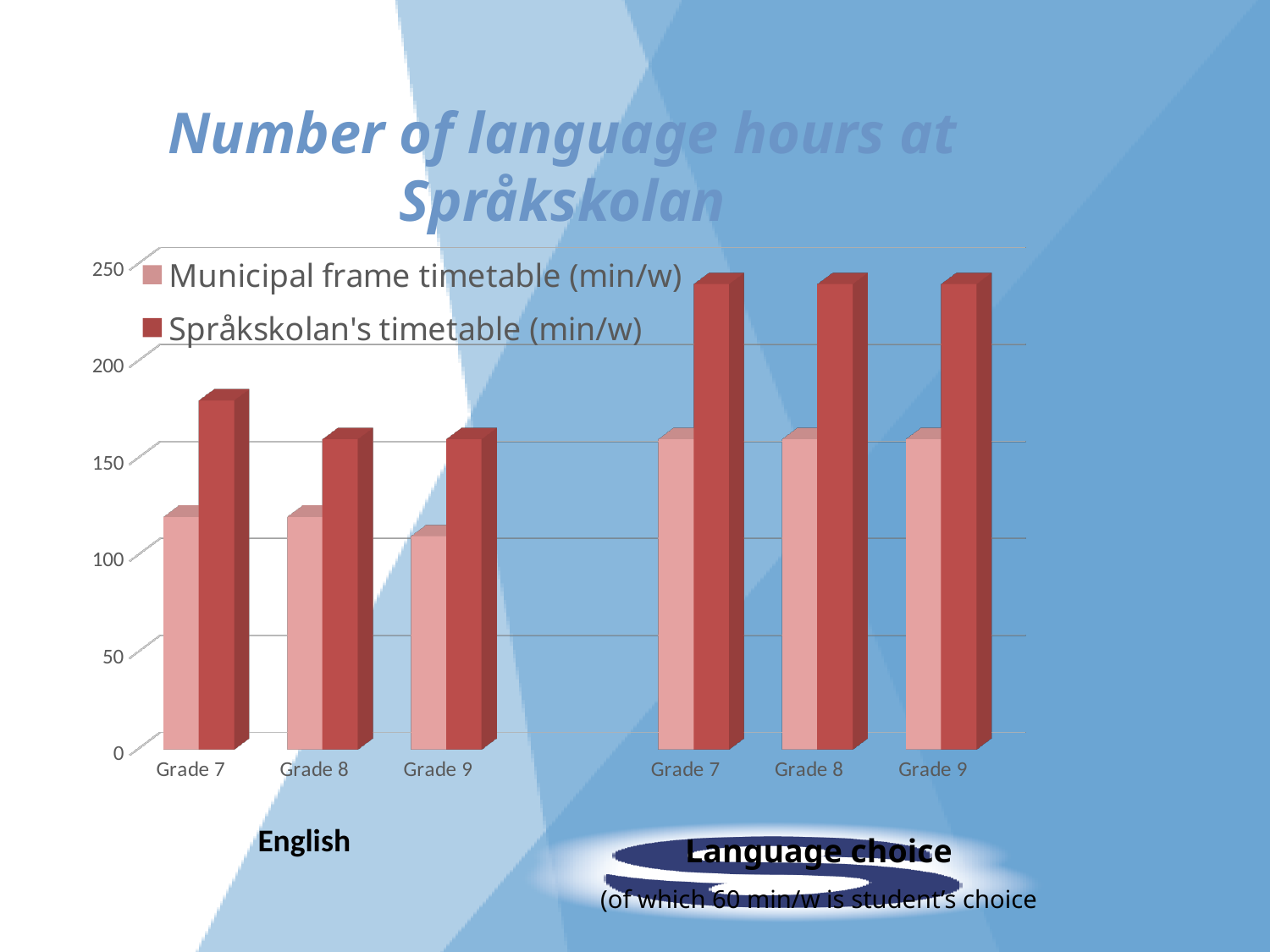
Is the Municipal frame timetable value for Grade 8 in the Language choice group greater or less than 100? greater How many series does the chart legend list? 2 Is the Språkskolan's timetable value for Grade 9 in the English group greater or less than 200? less What is the title of the chart on the slide? Number of language hours at Språkskolan What kind of chart is shown on the slide? bar chart Is the Municipal frame timetable value for Grade 9 in the English group greater or less than 150? less Within the English group, which grade has the highest Språkskolan's timetable value? Grade 7 For Grade 7 in the English group, which is larger: the Municipal frame timetable or Språkskolan's timetable? Språkskolan's timetable Which series is shown in the darker red colour in the chart? Språkskolan's timetable (min/w) How many grade categories are plotted along the x axis of the chart? 6